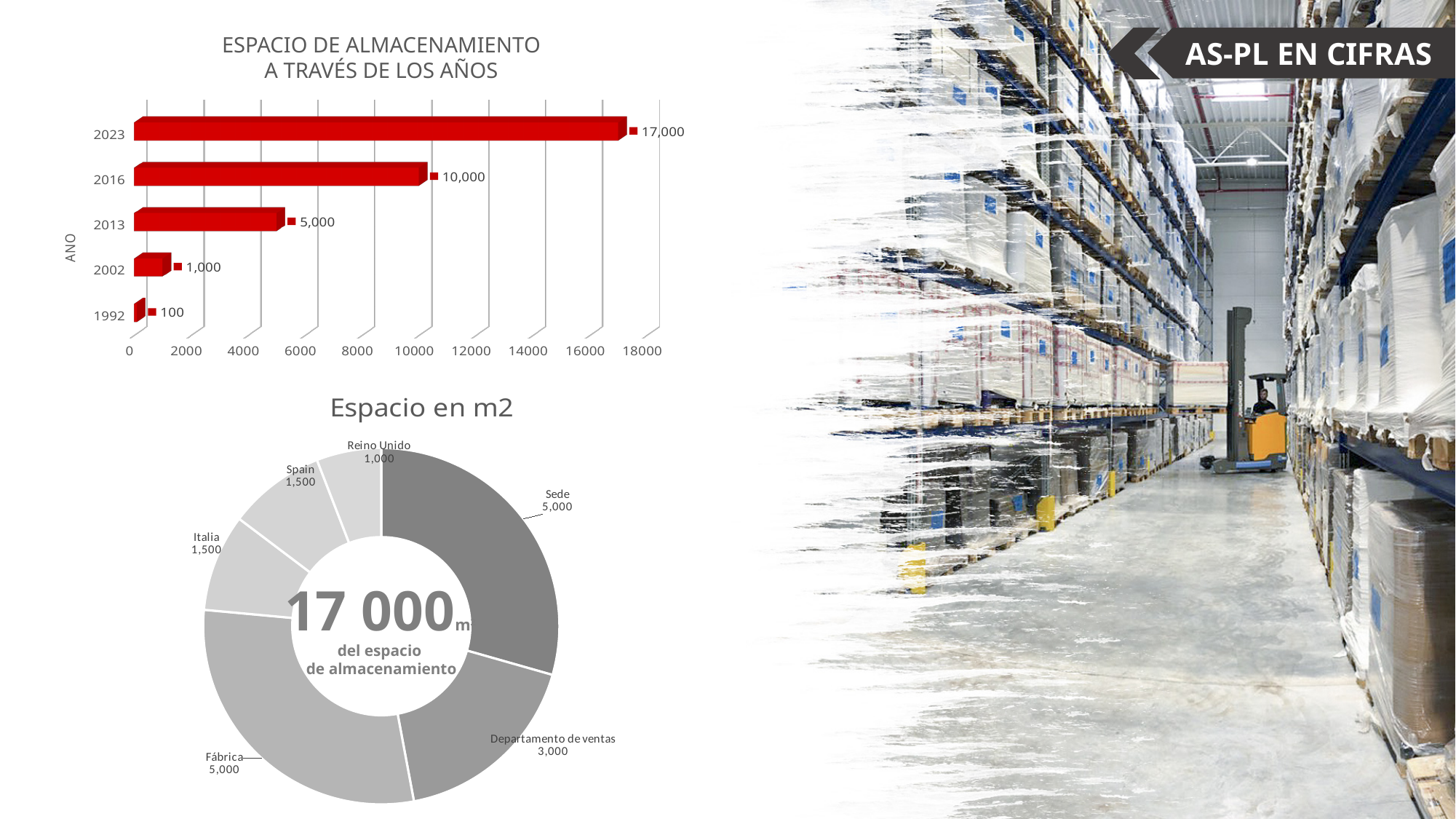
In the chart 'ESPACIO DE ALMACENAMIENTO A TRAVÉS DE LOS AÑOS', do the values rise or fall from 1992 to 2023? Rise In the chart 'ESPACIO DE ALMACENAMIENTO A TRAVÉS DE LOS AÑOS', which year has the lowest value? 1992 In the chart 'Espacio en m2', what is the value for Reino Unido? 1,000 What kind of chart is 'ESPACIO DE ALMACENAMIENTO A TRAVÉS DE LOS AÑOS'? Bar chart In the chart 'Espacio en m2', what is the value for Departamento de ventas? 3,000 In the chart 'Espacio en m2', which is larger, Fábrica or Italia? Fábrica In the chart 'Espacio en m2', how many categories are shown? 6 In the chart 'ESPACIO DE ALMACENAMIENTO A TRAVÉS DE LOS AÑOS', what is the difference between the values for 2023 and 2016? 7,000 In the chart 'ESPACIO DE ALMACENAMIENTO A TRAVÉS DE LOS AÑOS', what is the value for 1992? 100 In the chart 'ESPACIO DE ALMACENAMIENTO A TRAVÉS DE LOS AÑOS', what is the value for 2023? 17,000 In the chart 'ESPACIO DE ALMACENAMIENTO A TRAVÉS DE LOS AÑOS', how many years are shown? 5 In the chart 'Espacio en m2', what is the difference between Sede and Spain? 3,500